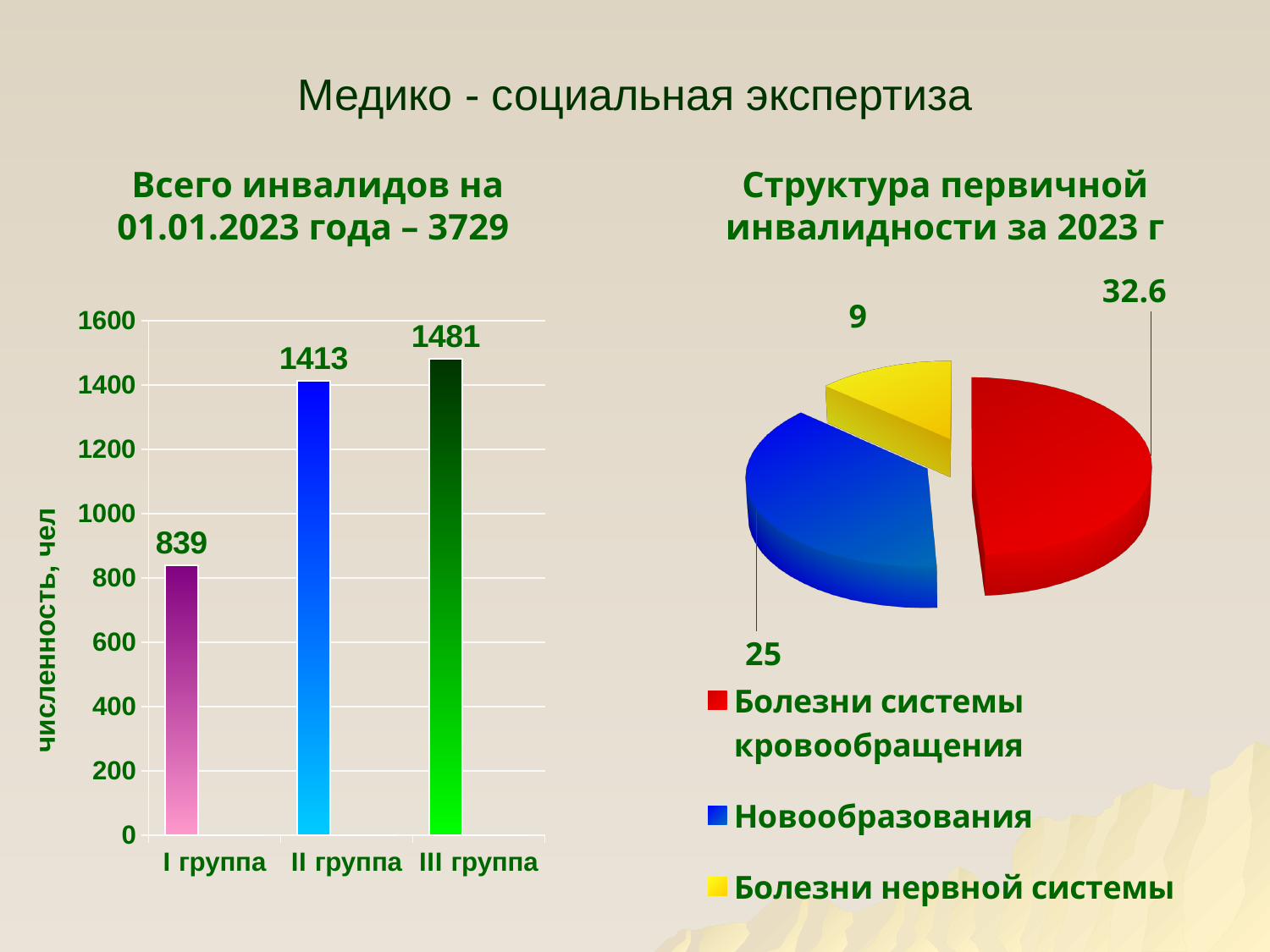
In the pie chart 'Структура первичной инвалидности за 2023 г', how many entries does the legend list? 3 In the bar chart 'Всего инвалидов на 01.01.2023 года – 3729', what is the value for II группа? 1413 In the bar chart 'Всего инвалидов на 01.01.2023 года – 3729', is the value for I группа greater or less than 1000? less In the bar chart 'Всего инвалидов на 01.01.2023 года – 3729', what is the value for I группа? 839 In the bar chart 'Всего инвалидов на 01.01.2023 года – 3729', which group has the lowest value? I группа In the bar chart 'Всего инвалидов на 01.01.2023 года – 3729', how many categories are shown on the x axis? 3 In the bar chart 'Всего инвалидов на 01.01.2023 года – 3729', what is the difference between III группа and II группа? 68 In the pie chart 'Структура первичной инвалидности за 2023 г', what is the value for Новообразования? 25 In the pie chart 'Структура первичной инвалидности за 2023 г', which category has the largest slice? Болезни системы кровообращения In the bar chart 'Всего инвалидов на 01.01.2023 года – 3729', do the values rise or fall from I группа to III группа? rise What kind of chart is the left chart 'Всего инвалидов на 01.01.2023 года – 3729'? bar chart In the bar chart 'Всего инвалидов на 01.01.2023 года – 3729', which group has the highest value? III группа